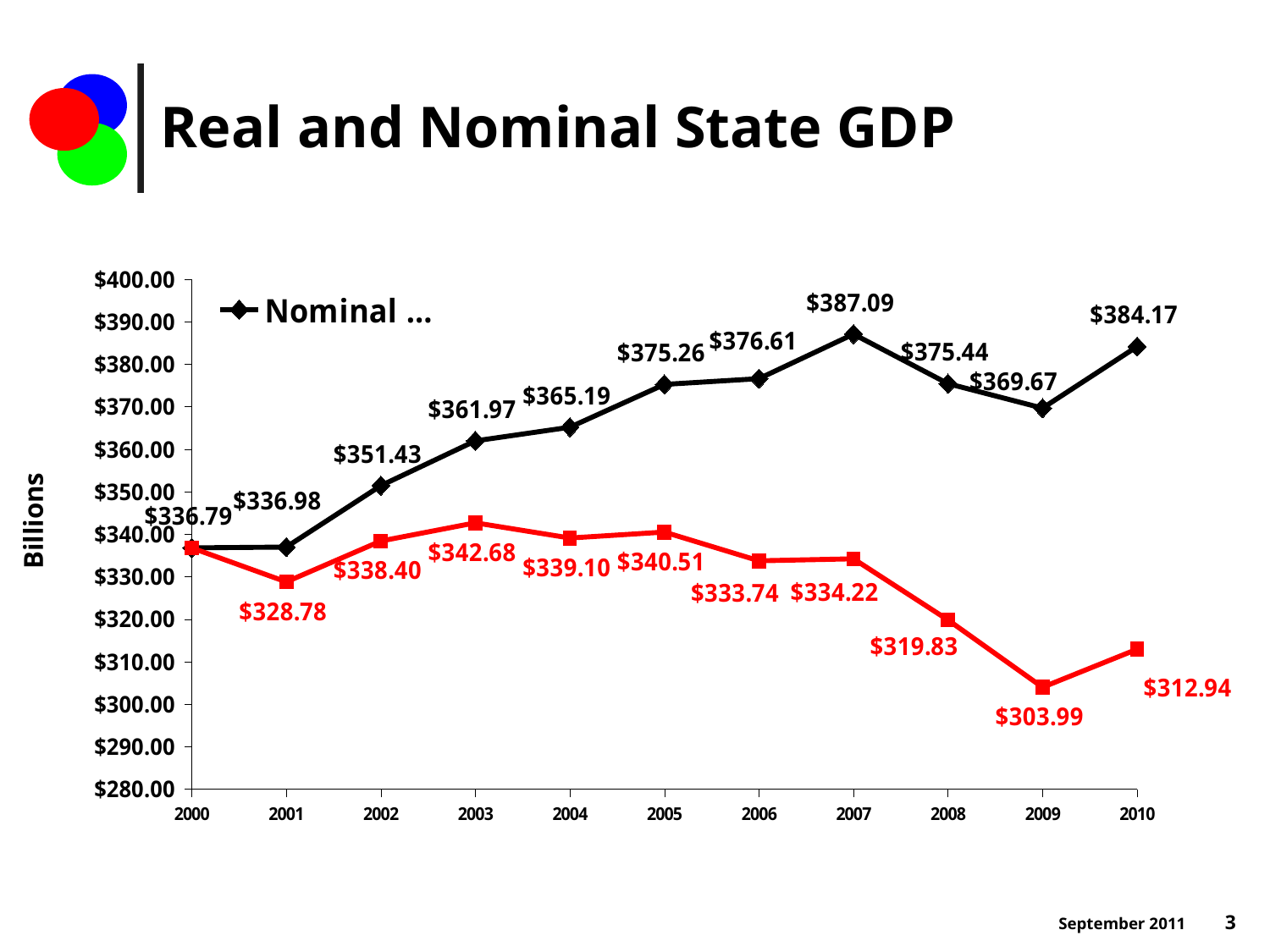
Is the value of the red series in 2000 greater or less than $350.00? less What kind of chart is shown on the slide? line chart What is the value of the red series in 2009? $303.99 Which is larger, the Nominal value for 2005 or for 2006? 2006 What is the difference between the Nominal values for 2010 and 2009? $14.50 How many years are plotted on the x axis? 11 What is the Nominal value for 2007? $387.09 In which year is the red series lowest? 2009 In which year is the Nominal series highest? 2007 What is the value of the red series in 2003? $342.68 What is the difference between the red series values for 2008 and 2009? $15.84 Does the red series rise or fall from 2005 to 2009? fall